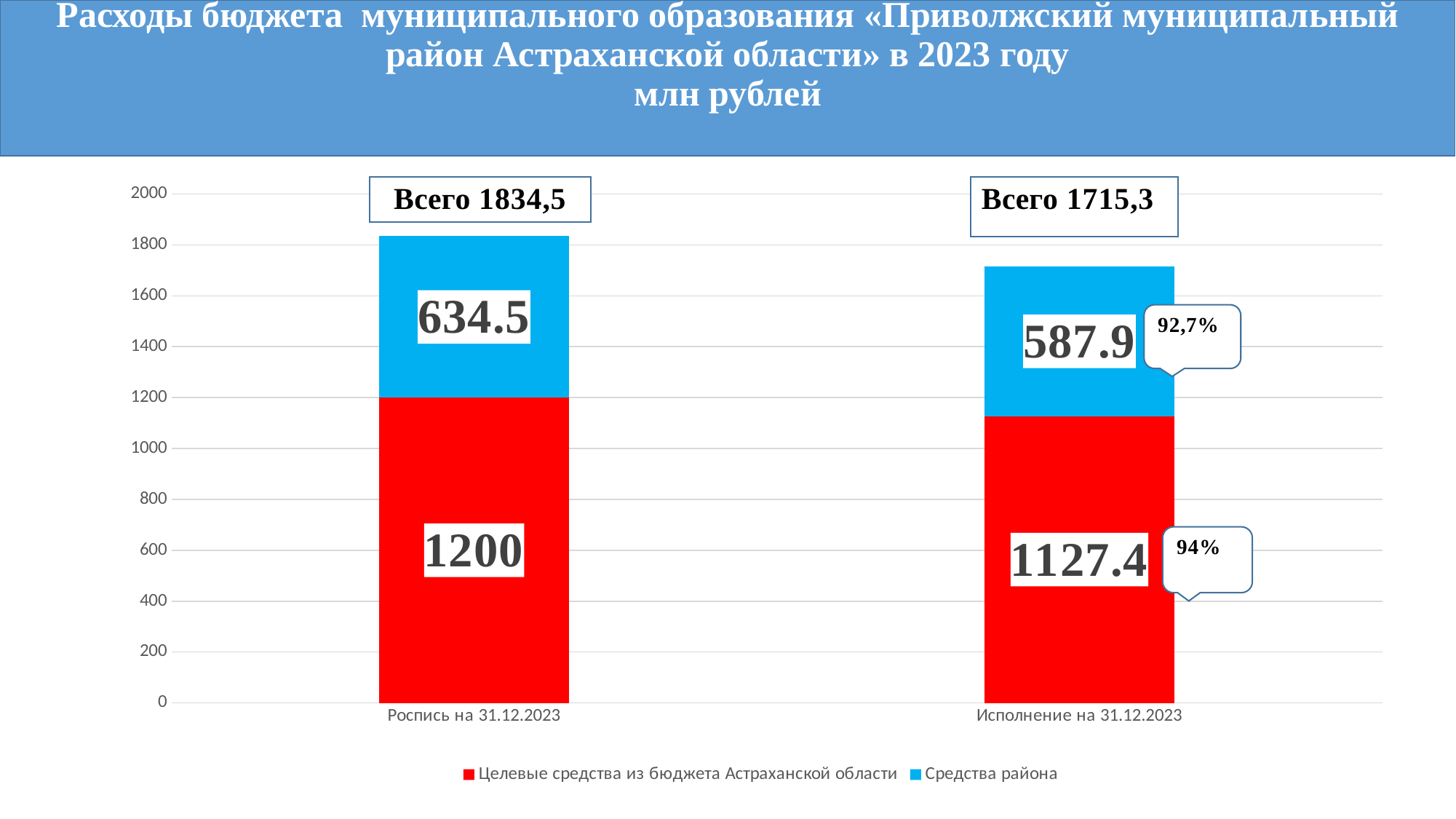
What is the value of «Целевые средства из бюджета Астраханской области» for «Исполнение на 31.12.2023»? 1127.4 How many series does the legend list? 2 What kind of chart is shown on the slide? Stacked bar chart What is the value of «Средства района» for «Исполнение на 31.12.2023»? 587.9 Which category has the higher value for «Средства района»? Роспись на 31.12.2023 What is the total shown for the «Роспись на 31.12.2023» bar? Всего 1834,5 What is the difference between «Целевые средства из бюджета Астраханской области» for «Роспись на 31.12.2023» and for «Исполнение на 31.12.2023»? 72.6 What is the value of «Средства района» for «Роспись на 31.12.2023»? 634.5 What is the value of «Целевые средства из бюджета Астраханской области» for «Роспись на 31.12.2023»? 1200 What is the total shown for the «Исполнение на 31.12.2023» bar? Всего 1715,3 How many categories are shown on the x axis? 2 What percentage is shown in the callout next to the «Средства района» segment of «Исполнение на 31.12.2023»? 92,7%